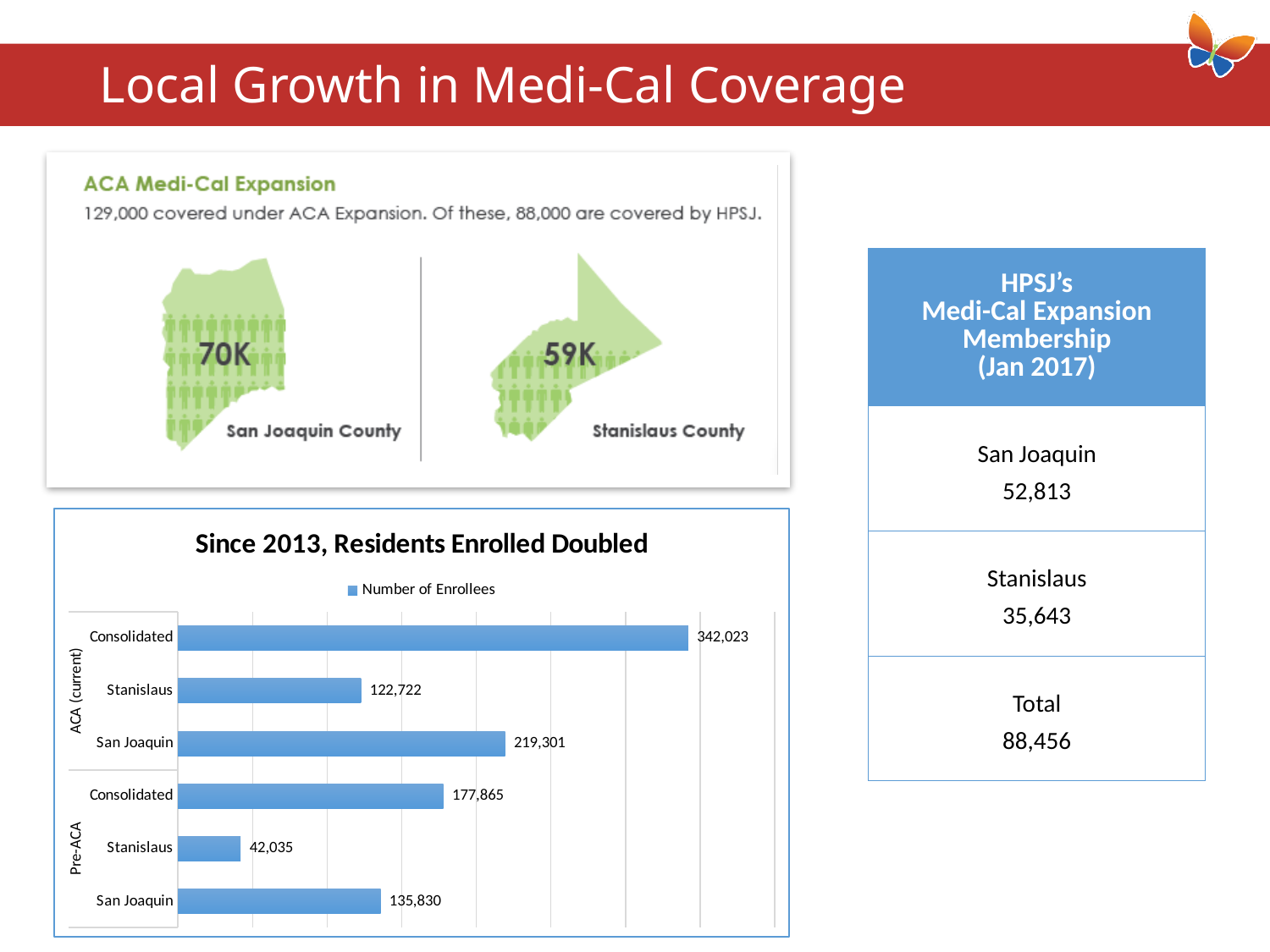
In the chart "Since 2013, Residents Enrolled Doubled", what is the number of enrollees for San Joaquin under ACA (current)? 219,301 In the chart "Since 2013, Residents Enrolled Doubled", which bar has the highest number of enrollees? Consolidated (ACA current) How many series does the legend of the chart "Since 2013, Residents Enrolled Doubled" list? 1 In the chart "Since 2013, Residents Enrolled Doubled", which is larger: Stanislaus under ACA (current) or San Joaquin under Pre-ACA? San Joaquin under Pre-ACA In the chart "Since 2013, Residents Enrolled Doubled", what is the number of enrollees for Consolidated under Pre-ACA? 177,865 In the chart "Since 2013, Residents Enrolled Doubled", what is the number of enrollees for Stanislaus under Pre-ACA? 42,035 In the chart "Since 2013, Residents Enrolled Doubled", which bar has the lowest number of enrollees? Stanislaus (Pre-ACA) In the chart "Since 2013, Residents Enrolled Doubled", what is the difference between the San Joaquin ACA (current) value and the San Joaquin Pre-ACA value? 83,471 How many bars are plotted in the chart "Since 2013, Residents Enrolled Doubled"? 6 What kind of chart is "Since 2013, Residents Enrolled Doubled"? Bar chart In the chart "Since 2013, Residents Enrolled Doubled", what is the number of enrollees for Consolidated under ACA (current)? 342,023 In the chart "Since 2013, Residents Enrolled Doubled", what is the difference between the Consolidated ACA (current) value and the Consolidated Pre-ACA value? 164,158